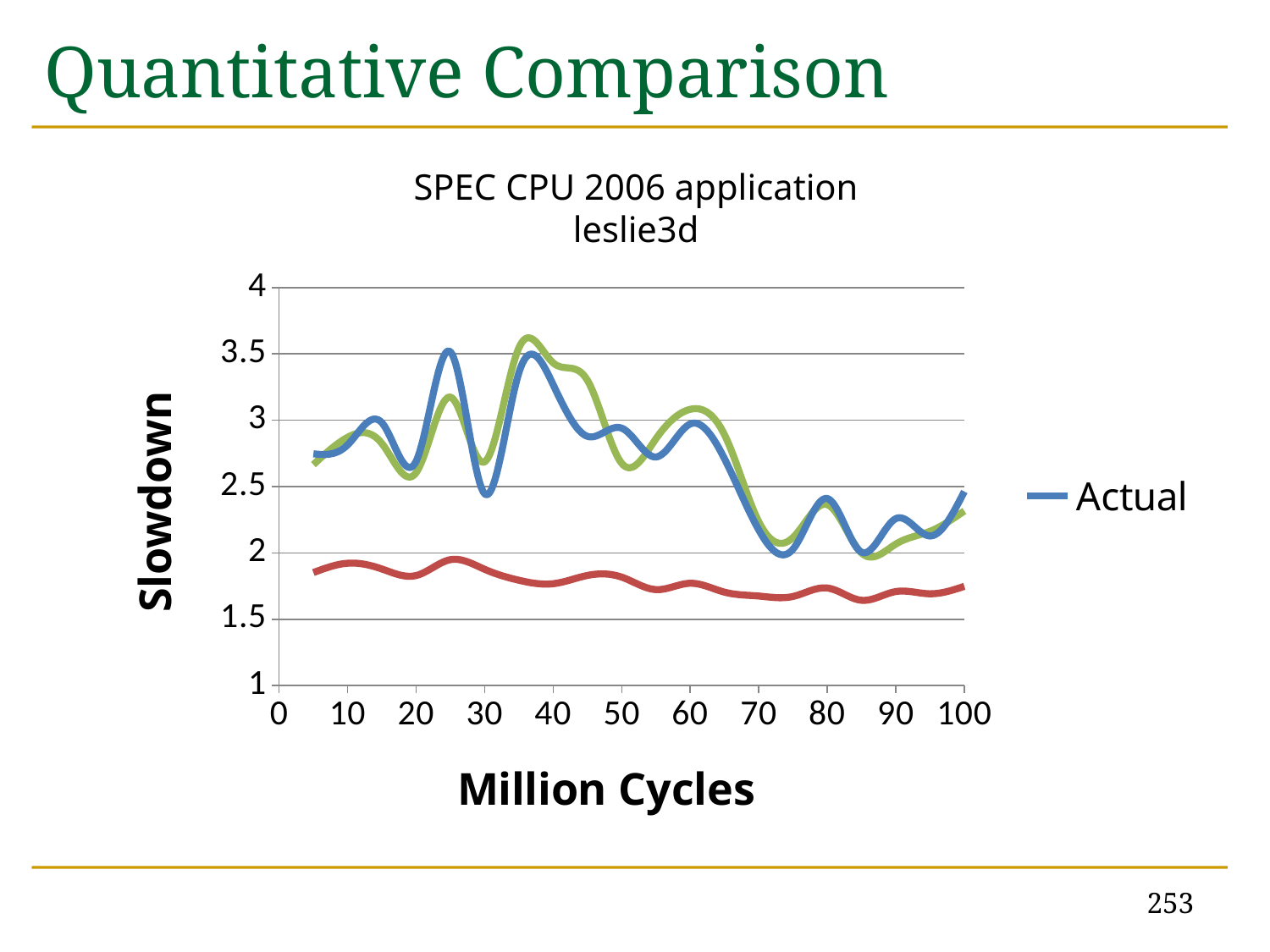
What is the title of the chart? SPEC CPU 2006 application leslie3d How many series does the chart's legend list? 1 Is the value of the Actual series at 25 million cycles greater or less than 3? greater What is the label of the y axis? Slowdown Is the value of the Actual series at 5 million cycles greater or less than 2.5? greater Is the value of the Actual series at 100 million cycles greater or less than 3? less Does the Actual series rise or fall between 85 and 100 million cycles? rise What kind of chart is shown on the slide? line chart Does the Actual series rise or fall between 60 and 75 million cycles? fall